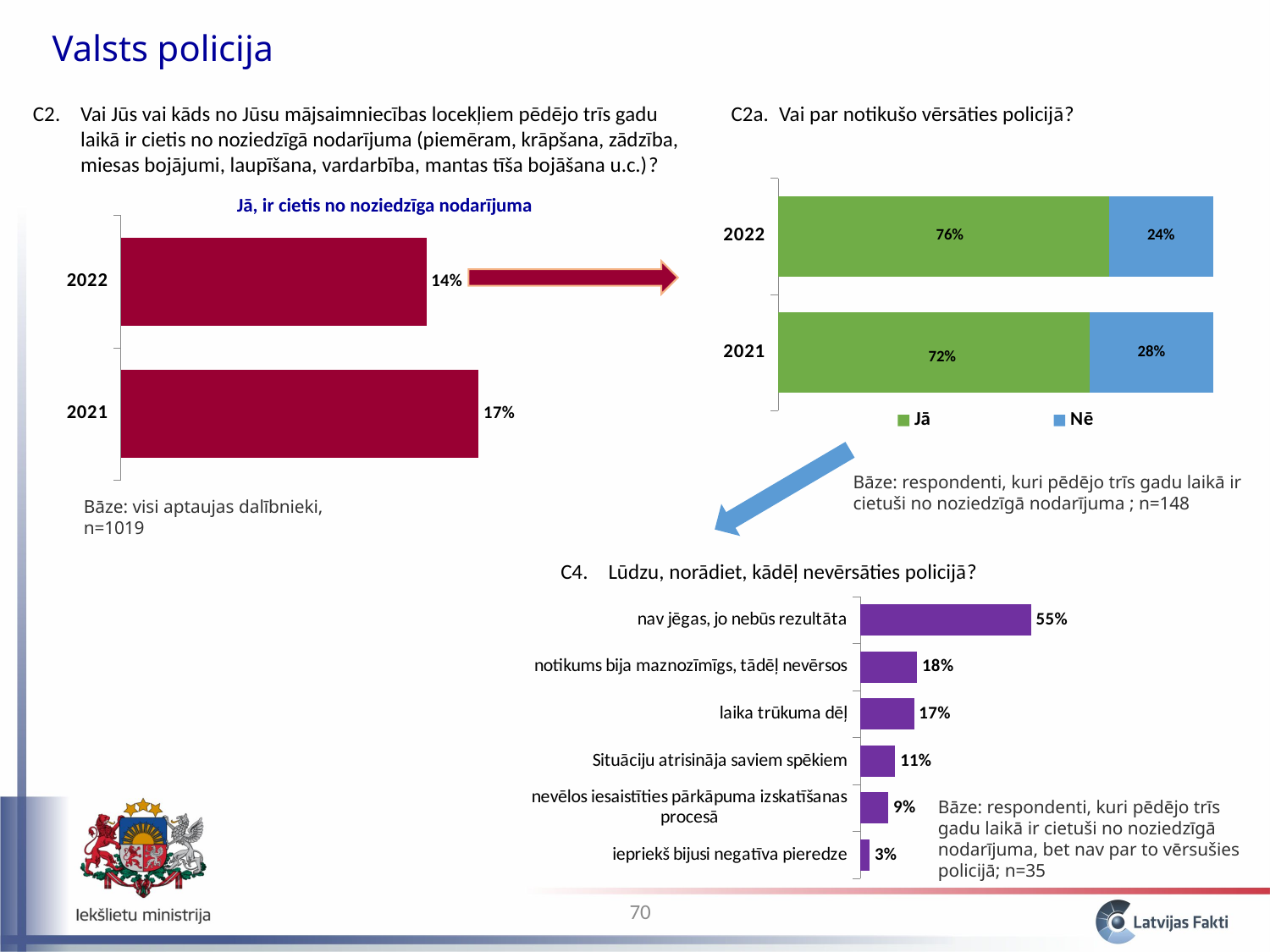
In the chart titled "Jā, ir cietis no noziedzīga nodarījuma", what is the difference between the 2021 and 2022 values? 3% In the chart titled "Jā, ir cietis no noziedzīga nodarījuma", which year has the higher value? 2021 In the chart titled "Jā, ir cietis no noziedzīga nodarījuma", what is the value for 2022? 14% In the C4 chart (bottom right), which category has the highest value? nav jēgas, jo nebūs rezultāta In the chart titled "Jā, ir cietis no noziedzīga nodarījuma", what is the value for 2021? 17% In the C2a chart (top right), what is the total of the stacked bar for 2021? 100% In the C2a chart (top right), what is the "Jā" value for 2022? 76% In the C4 chart (bottom right), how many categories are shown? 6 In the C2a chart (top right), what is the "Nē" value for 2021? 28% In the C4 chart (bottom right), which category has the lowest value? iepriekš bijusi negatīva pieredze In the C4 chart (bottom right), what is the value for "laika trūkuma dēļ"? 17% In the C2a chart (top right), how many series does the legend list? 2